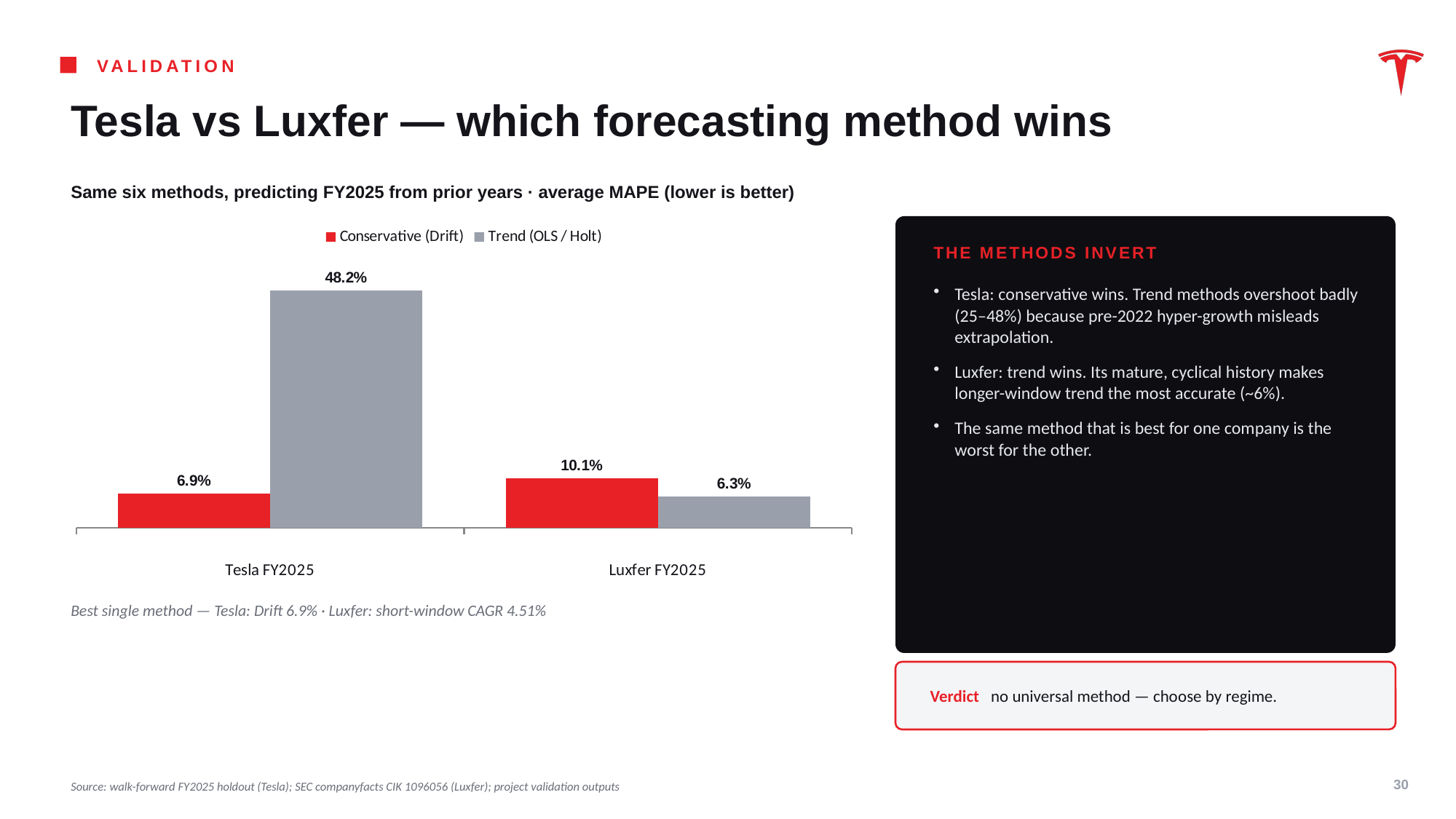
What kind of chart is shown on the slide? Bar chart How many series does the chart legend list? 2 What is the Trend (OLS / Holt) value for Luxfer FY2025? 6.3% Which bar in the chart has the lowest value? Trend (OLS / Holt) for Luxfer FY2025 Which bar in the chart has the highest value? Trend (OLS / Holt) for Tesla FY2025 For Luxfer FY2025, which is larger: Conservative (Drift) or Trend (OLS / Holt)? Conservative (Drift) What is the difference between the Trend (OLS / Holt) and Conservative (Drift) values for Tesla FY2025? 41.3% What is the Conservative (Drift) value for Tesla FY2025? 6.9% What is the Conservative (Drift) value for Luxfer FY2025? 10.1% How many categories are shown on the x axis of the chart? 2 What is the Trend (OLS / Holt) value for Tesla FY2025? 48.2% What is the difference between the Conservative (Drift) and Trend (OLS / Holt) values for Luxfer FY2025? 3.8%